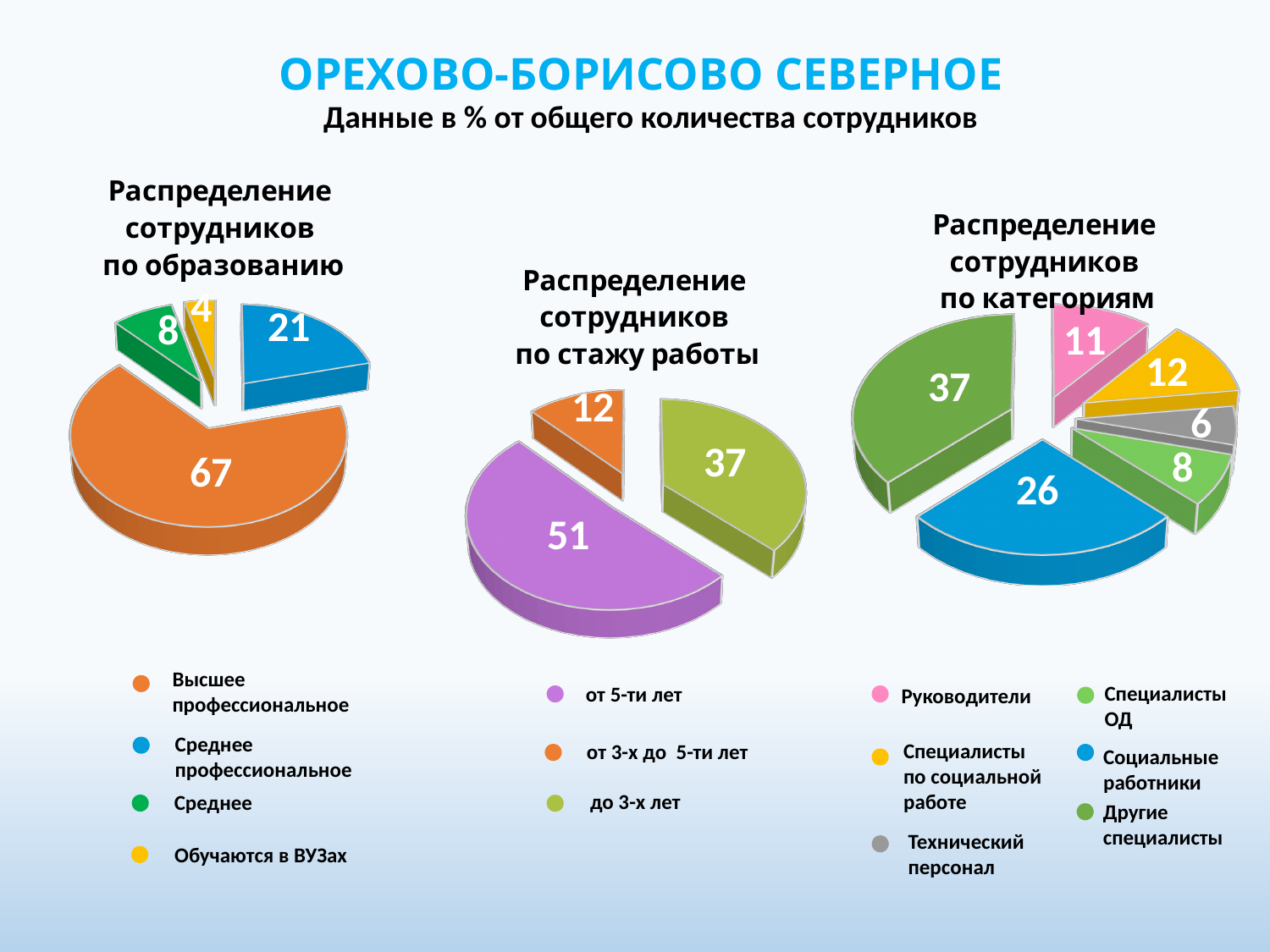
In the chart 'Распределение сотрудников по стажу работы', what is the value for 'от 5-ти лет'? 51 In the chart 'Распределение сотрудников по категориям', what is the value for 'Социальные работники'? 26 In the chart 'Распределение сотрудников по образованию', which category has the smallest slice? Обучаются в ВУЗах In the chart 'Распределение сотрудников по категориям', which is larger: 'Руководители' or 'Специалисты по социальной работе'? Специалисты по социальной работе In the chart 'Распределение сотрудников по образованию', what is the value for 'Высшее профессиональное'? 67 In the chart 'Распределение сотрудников по стажу работы', which category has the largest slice? от 5-ти лет How many categories does the legend of the chart 'Распределение сотрудников по категориям' list? 6 In the chart 'Распределение сотрудников по категориям', what colour is the slice for 'Другие специалисты'? Green In the chart 'Распределение сотрудников по образованию', what is the difference between 'Среднее профессиональное' and 'Среднее'? 13 What type of chart is 'Распределение сотрудников по образованию'? Pie chart In the chart 'Распределение сотрудников по категориям', which category has the smallest slice? Технический персонал How many slices does the chart 'Распределение сотрудников по стажу работы' have? 3